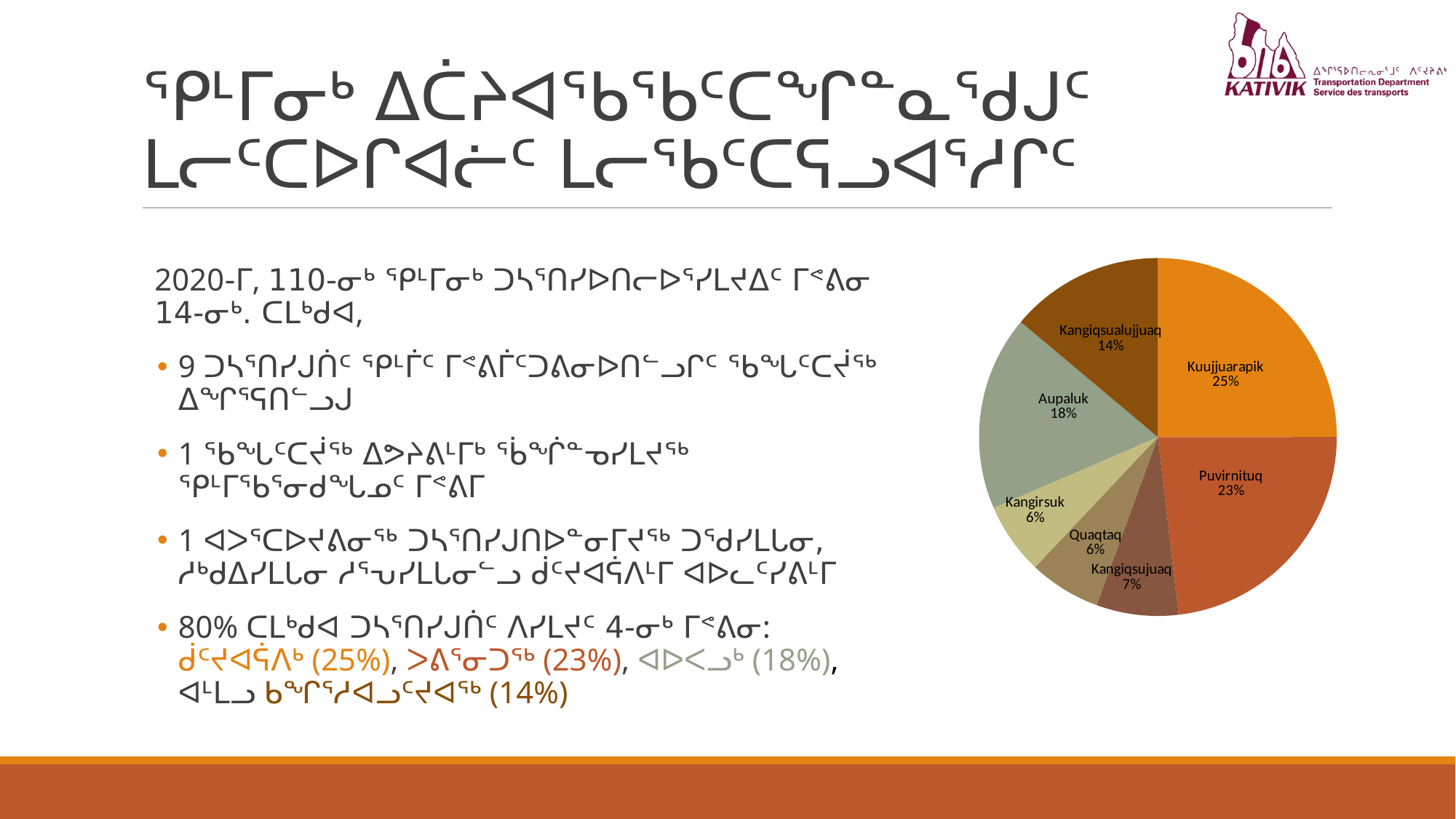
What share of the pie chart does Kuujjuarapik have? 25% What kind of chart is shown on the slide? pie chart What is the difference in percentage points between Aupaluk and Kangiqsujuaq in the pie chart? 11 How many slices does the pie chart have? 7 Which has a larger share in the pie chart, Aupaluk or Kangiqsualujjuaq? Aupaluk What share of the pie chart does Kangiqsujuaq have? 7% What share of the pie chart does Aupaluk have? 18% What share of the pie chart does Puvirnituq have? 23% What is the difference in percentage points between Kuujjuarapik and Puvirnituq in the pie chart? 2 Which slice of the pie chart is the largest? Kuujjuarapik Which has a larger share in the pie chart, Kangiqsujuaq or Quaqtaq? Kangiqsujuaq What share of the pie chart does Kangiqsualujjuaq have? 14%